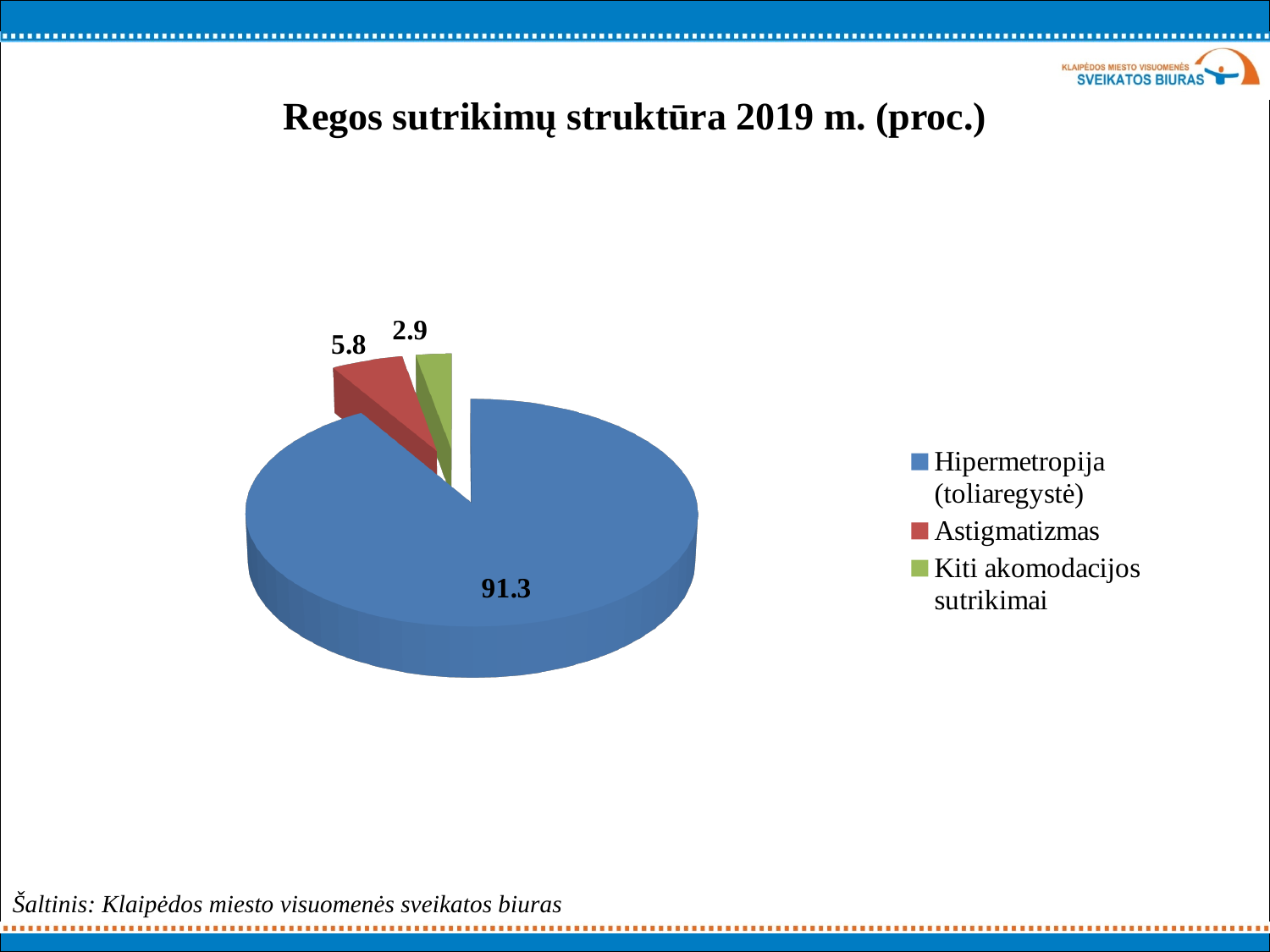
What is the value for Astigmatizmas? 5.8 Which is larger, the value for Astigmatizmas or the value for Kiti akomodacijos sutrikimai? Astigmatizmas Which category has the smallest share of the pie? Kiti akomodacijos sutrikimai What is the difference between the values for Hipermetropija (toliaregystė) and Astigmatizmas? 85.5 What is the value for Kiti akomodacijos sutrikimai? 2.9 What is the value for Hipermetropija (toliaregystė)? 91.3 What is the title of the chart? Regos sutrikimų struktūra 2019 m. (proc.) What is the difference between the values for Astigmatizmas and Kiti akomodacijos sutrikimai? 2.9 What type of chart is shown on the slide? pie chart What colour is the slice for Astigmatizmas? red How many categories does the pie chart have? 3 Which category has the largest share of the pie? Hipermetropija (toliaregystė)